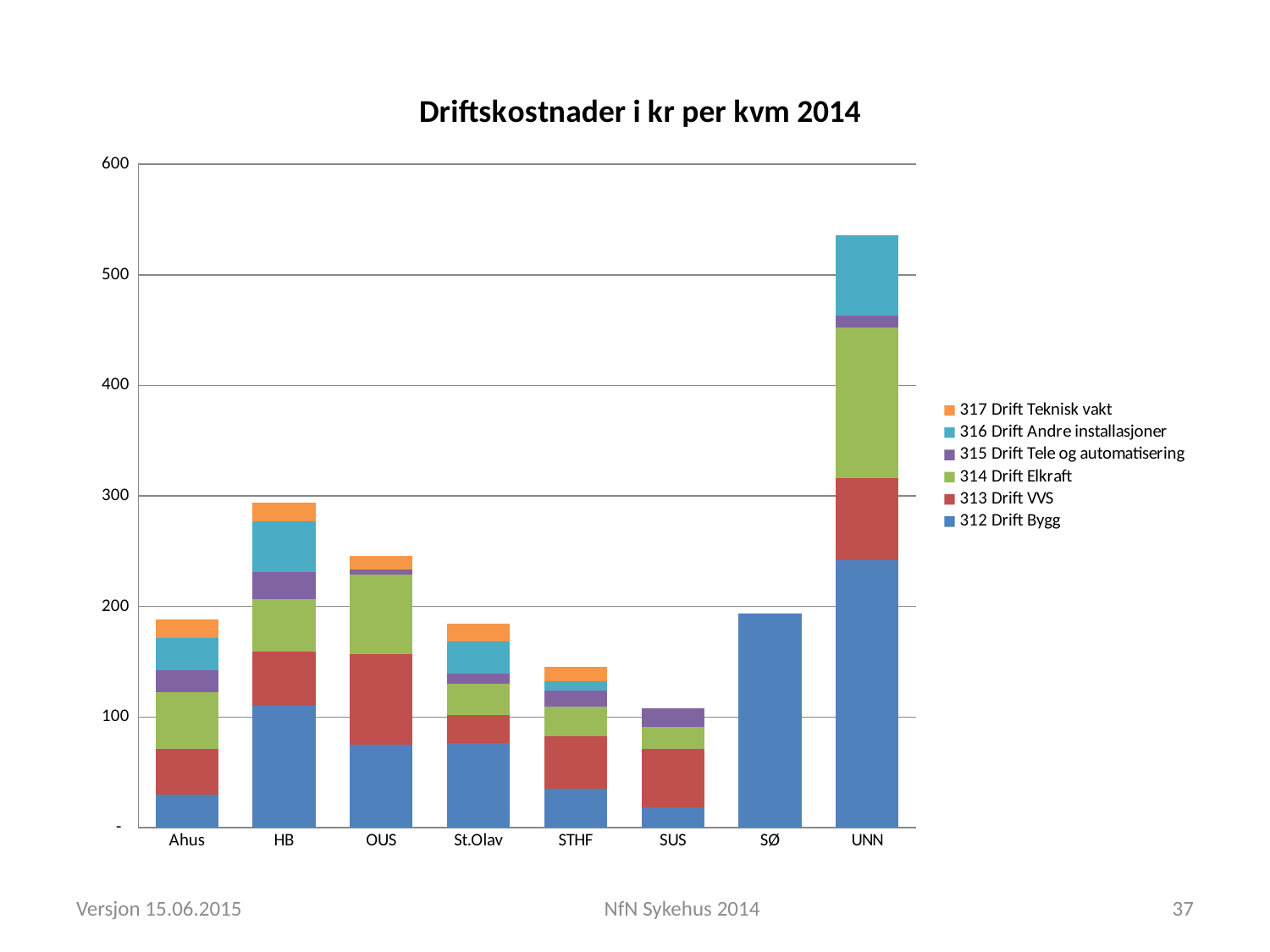
Which series forms the bottom segment of each stacked bar? 312 Drift Bygg Is the total value for OUS greater or less than 200? greater Is the total value for UNN greater or less than 500? greater Which has the larger total, HB or OUS? HB What kind of chart is shown on the slide? Stacked bar chart Which has the larger total, STHF or SUS? STHF How many hospitals (categories) are shown on the x axis? 8 Which hospital has the highest total driftskostnader per kvm? UNN How many series does the legend list? 6 Is the total value for Ahus greater or less than 200? less Which hospital has the lowest total driftskostnader per kvm? SUS What is the title of the chart? Driftskostnader i kr per kvm 2014